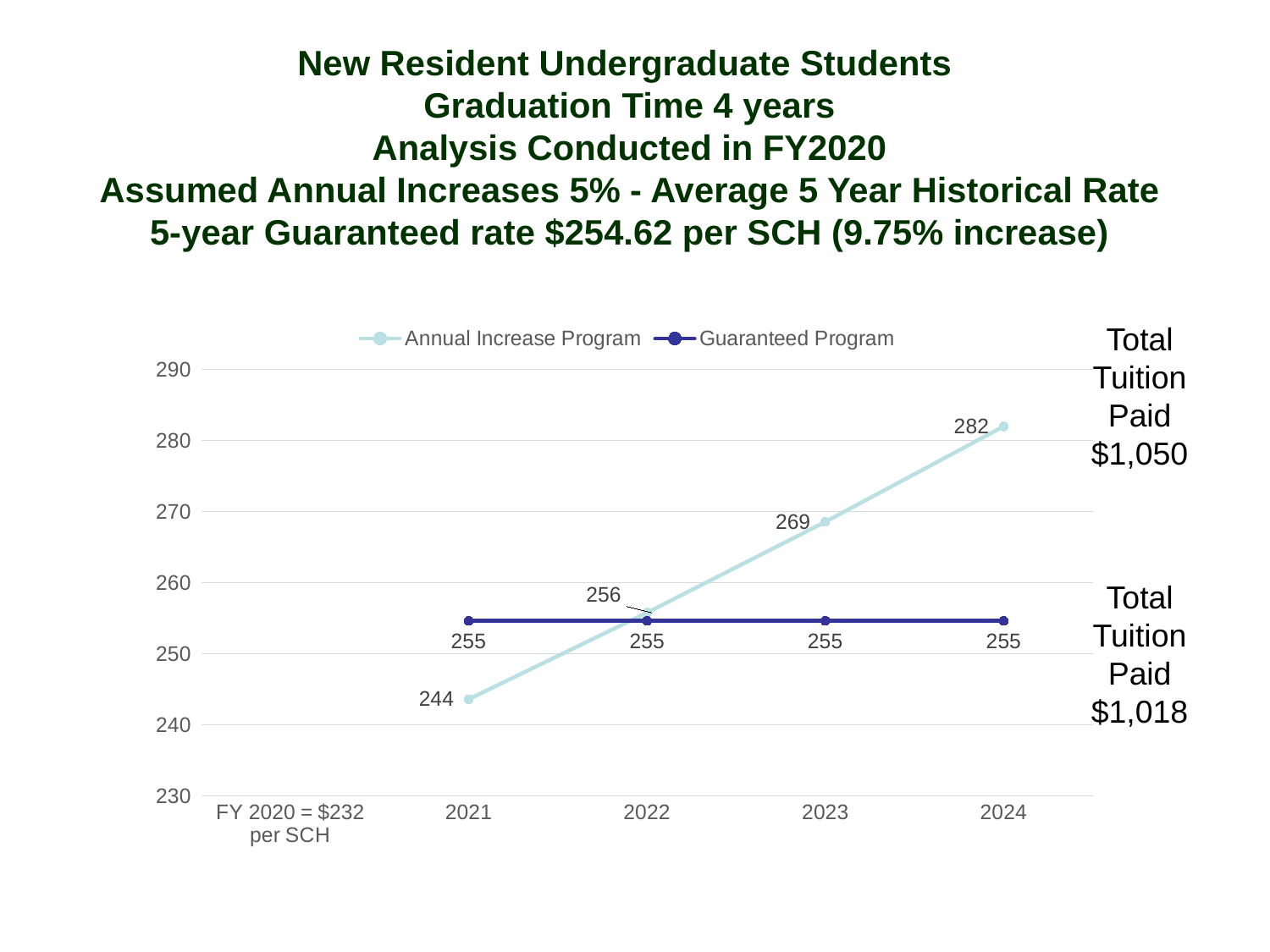
What is the value of the Guaranteed Program in 2023? 255 Does the Annual Increase Program rise or fall from 2021 to 2024? rise In which year is the Annual Increase Program value highest? 2024 What type of chart is shown on the slide? line chart How many data points are plotted for the Guaranteed Program series? 4 How many series does the chart legend list? 2 What is the difference between the Annual Increase Program value in 2024 and in 2021? 38 In which year is the Annual Increase Program value lowest? 2021 Which series has the larger value in 2021, Annual Increase Program or Guaranteed Program? Guaranteed Program What is the value of the Annual Increase Program in 2021? 244 What is the value of the Annual Increase Program in 2024? 282 What total tuition paid is shown for the Annual Increase Program? $1,050